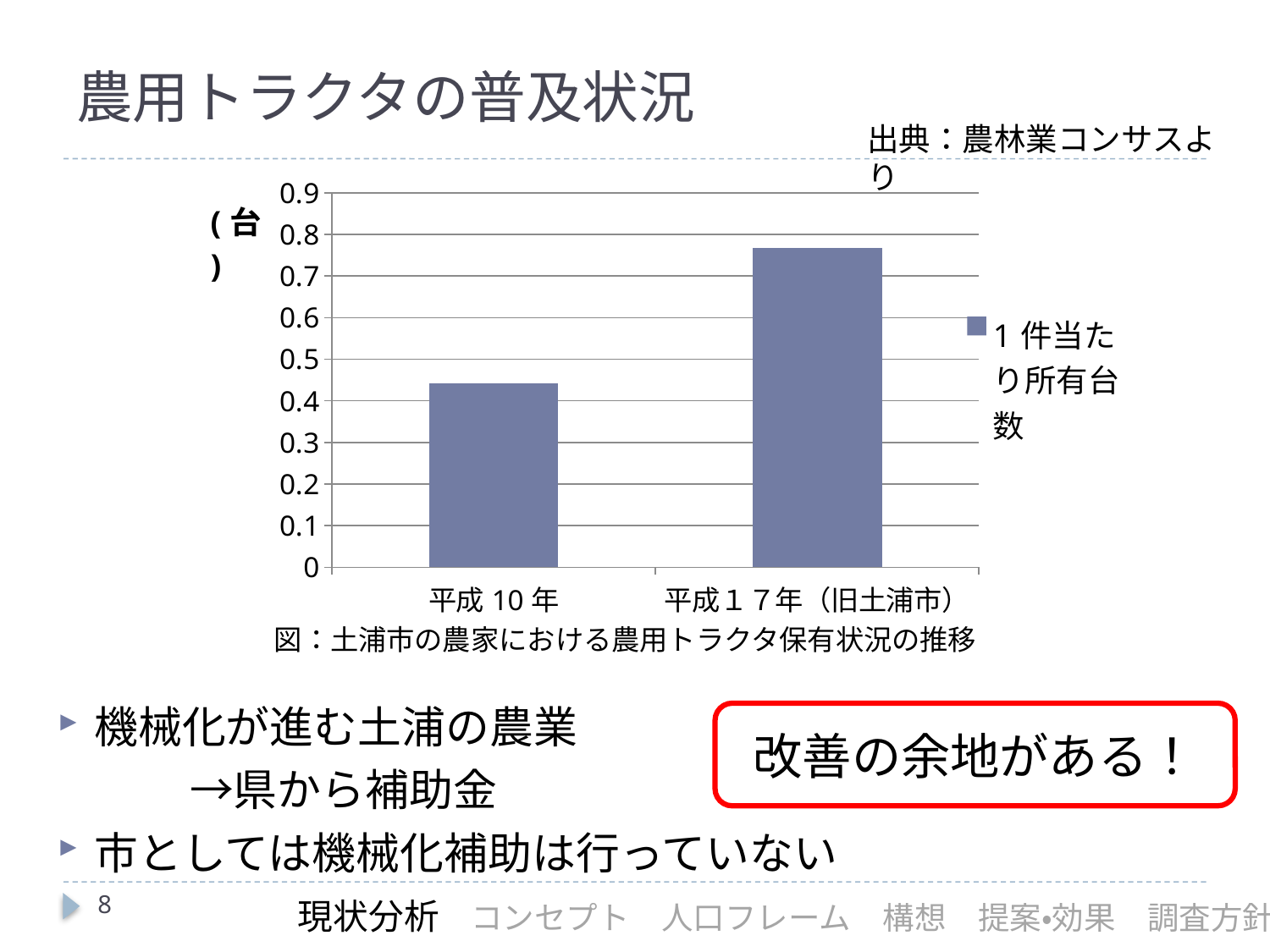
Do the values rise or fall from 平成10年 to 平成１７年（旧土浦市）? rise What is the series name shown in the chart legend? 1件当たり所有台数 Which category has the highest value in the chart? 平成１７年（旧土浦市） Is the value for 平成10年 greater or less than 0.5? less Is the value for 平成１７年（旧土浦市） greater or less than 0.8? less Which category has the lowest value in the chart? 平成10年 How many series does the chart legend list? 1 Is the value for 平成１７年（旧土浦市） greater or less than 0.7? greater What kind of chart is shown on the slide? bar chart What is the caption written below the chart? 図：土浦市の農家における農用トラクタ保有状況の推移 Which is larger, the value for 平成10年 or the value for 平成１７年（旧土浦市）? 平成１７年（旧土浦市） How many categories are plotted on the x axis of the chart? 2